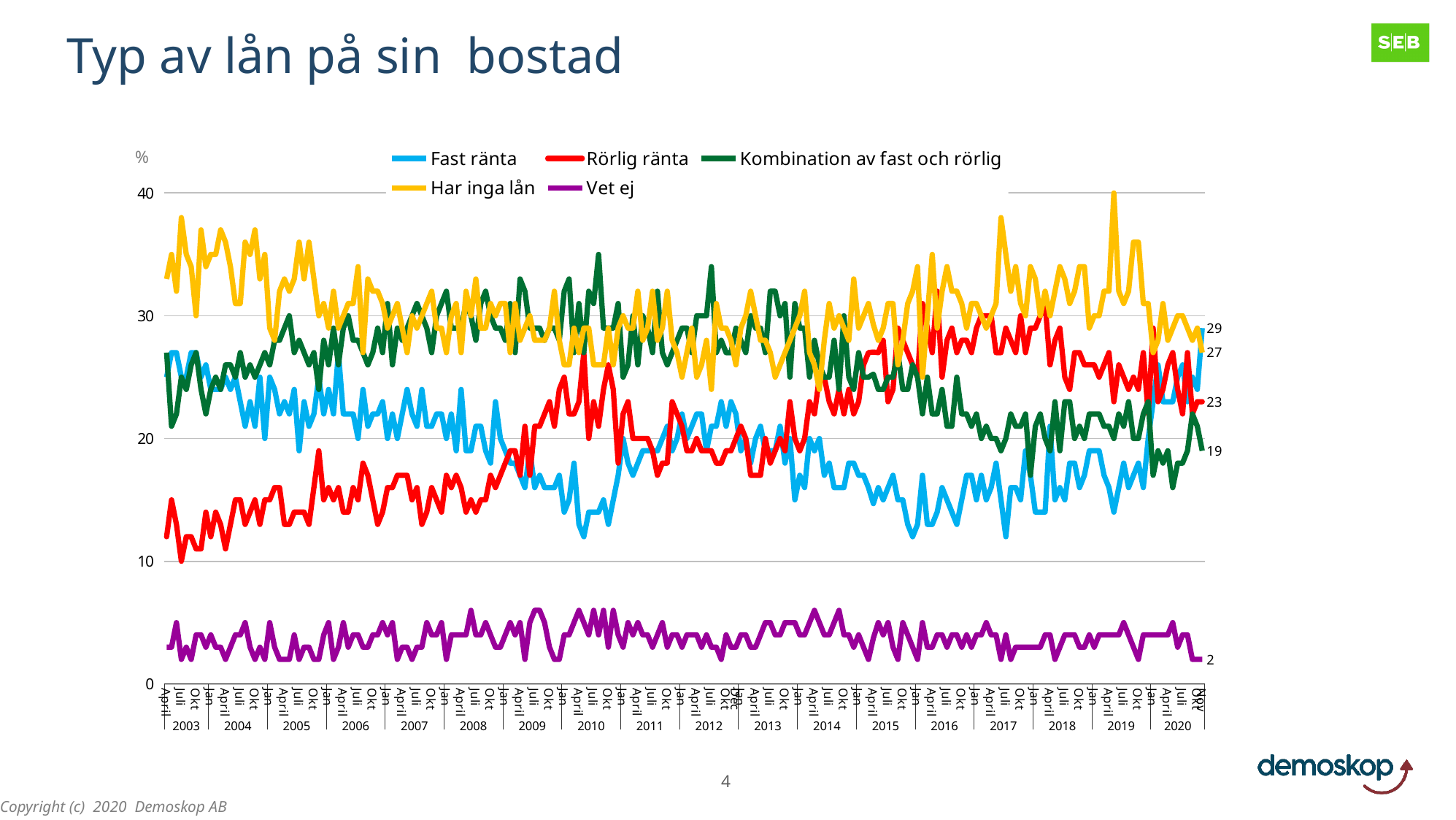
Is the value for Vet ej in 2010 greater or less than 10? less How many series does the legend list? 5 What is the difference between the final values of Har inga lån and Kombination av fast och rörlig? 8 What is the title of the chart on the slide? Typ av lån på sin bostad What is the final labelled value for Har inga lån at the right end of the chart? 27 What is the final labelled value for Fast ränta at the right end of the chart? 29 At the right end of the chart, which is larger: Fast ränta or Rörlig ränta? Fast ränta What is the final labelled value for Vet ej at the right end of the chart? 2 Which series has the highest value at the right end of the chart? Fast ränta What is the final labelled value for Rörlig ränta at the right end of the chart? 23 What is the final labelled value for Kombination av fast och rörlig at the right end of the chart? 19 What type of chart is shown on the slide? line chart